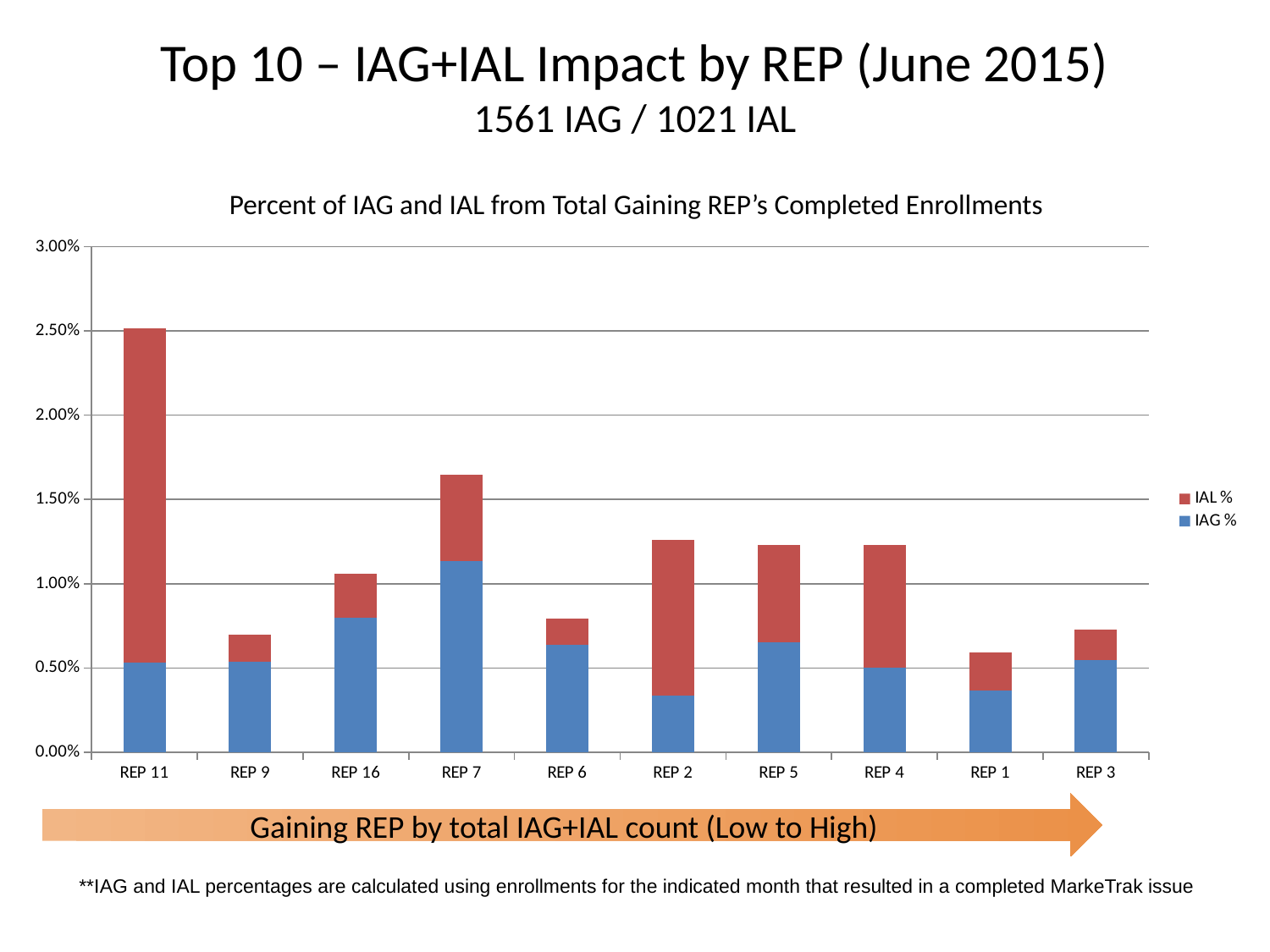
Which REP has the highest total IAG+IAL percentage? REP 11 Is the IAG % value for REP 2 greater or less than 0.50%? less What is the title of the chart? Percent of IAG and IAL from Total Gaining REP's Completed Enrollments Which has the larger total IAG+IAL percentage, REP 16 or REP 9? REP 16 How many series does the chart legend list? 2 Is the total IAG+IAL value for REP 11 greater or less than 2.00%? greater Is the total IAG+IAL value for REP 9 greater or less than 1.00%? less How many REPs are shown on the x axis of the chart? 10 Which has the larger IAG % value, REP 7 or REP 2? REP 7 Which REP has the highest IAG % value? REP 7 Which REP has the lowest total IAG+IAL percentage? REP 1 What kind of chart is shown on the slide? Stacked bar chart